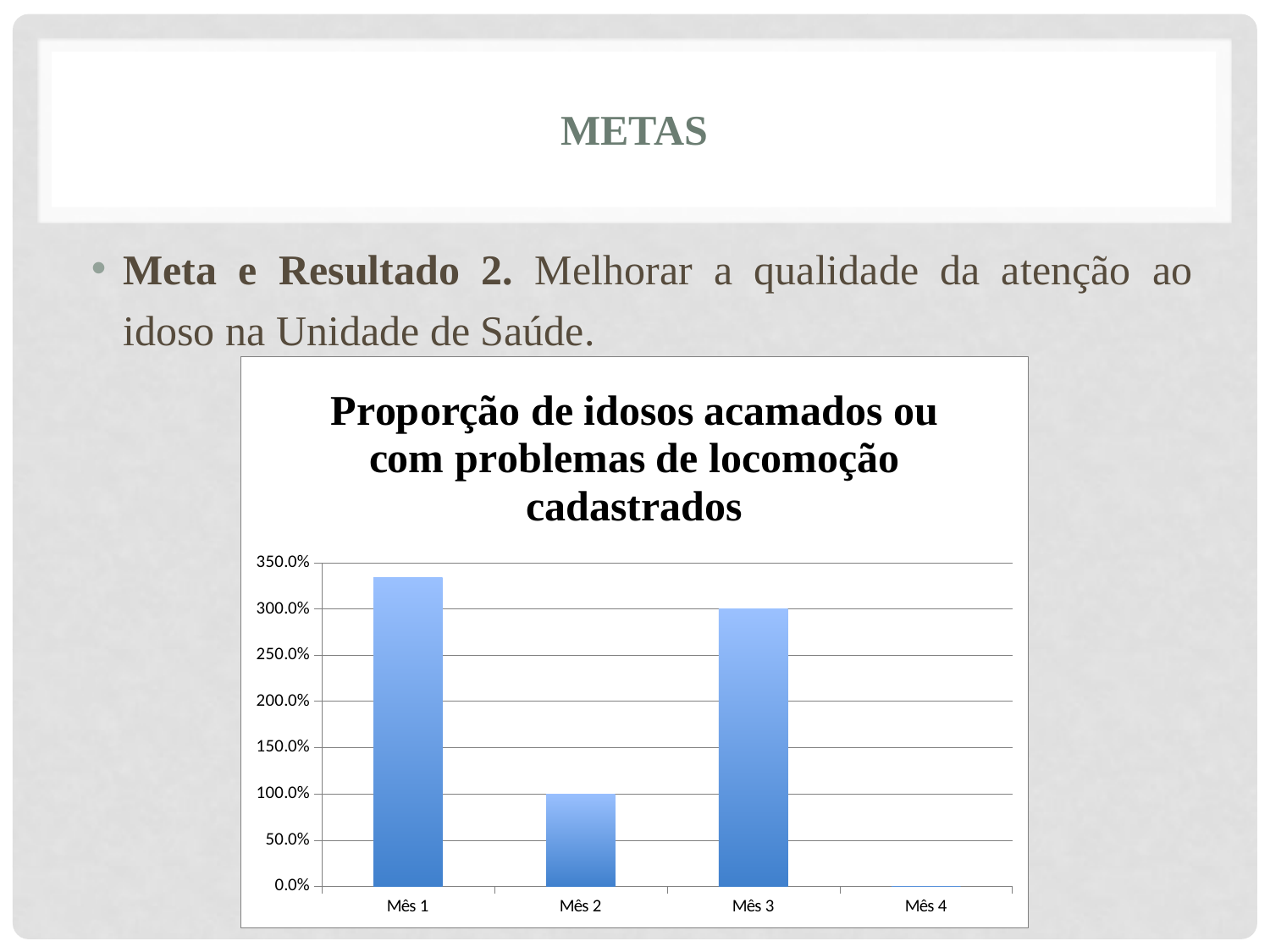
Which month has the highest value in the chart? Mês 1 What is the value for Mês 3? 300.0% Which is larger, the value for Mês 2 or the value for Mês 3? Mês 3 How many categories are shown on the x axis of the chart? 4 Which is larger, the value for Mês 1 or the value for Mês 3? Mês 1 Is the value for Mês 2 greater or less than 150.0%? less What kind of chart is shown on the slide? bar chart What is the difference between the values for Mês 3 and Mês 2? 200.0% What is the value for Mês 2? 100.0% Among Mês 1, Mês 2 and Mês 3, which month has the lowest value? Mês 2 Is the value for Mês 1 greater or less than 300.0%? greater What is the title of the chart? Proporção de idosos acamados ou com problemas de locomoção cadastrados